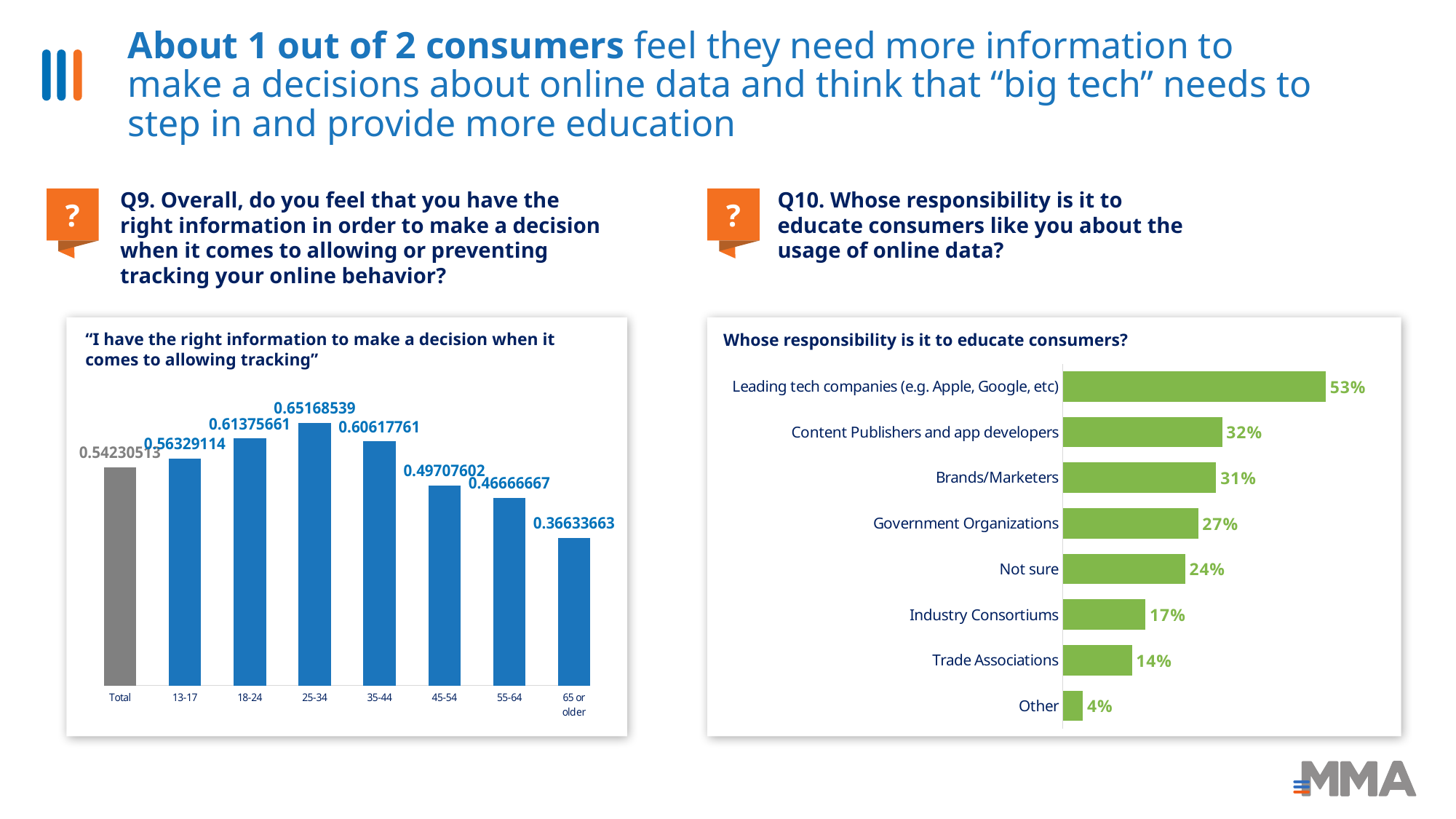
In the left chart, what is the value for the Total bar? 0.54230513 In the left chart, which age group has the lowest value? 65 or older In the right chart, which category has the highest percentage? Leading tech companies (e.g. Apple, Google, etc) In the left chart, which age group has the highest value? 25-34 In the left chart, do the values rise or fall from the 25-34 group to the 65 or older group? fall What type of chart is the right chart? bar chart In the left chart, is the value for 18-24 larger or smaller than the value for 35-44? larger In the right chart, what is the difference between Leading tech companies and Content Publishers and app developers? 21% In the right chart ("Whose responsibility is it to educate consumers?"), what percentage is shown for Government Organizations? 27% In the left chart ("I have the right information to make a decision when it comes to allowing tracking"), what is the value for the 25-34 age group? 0.65168539 In the left chart, how many bars are plotted? 8 In the right chart, how many categories are shown? 8